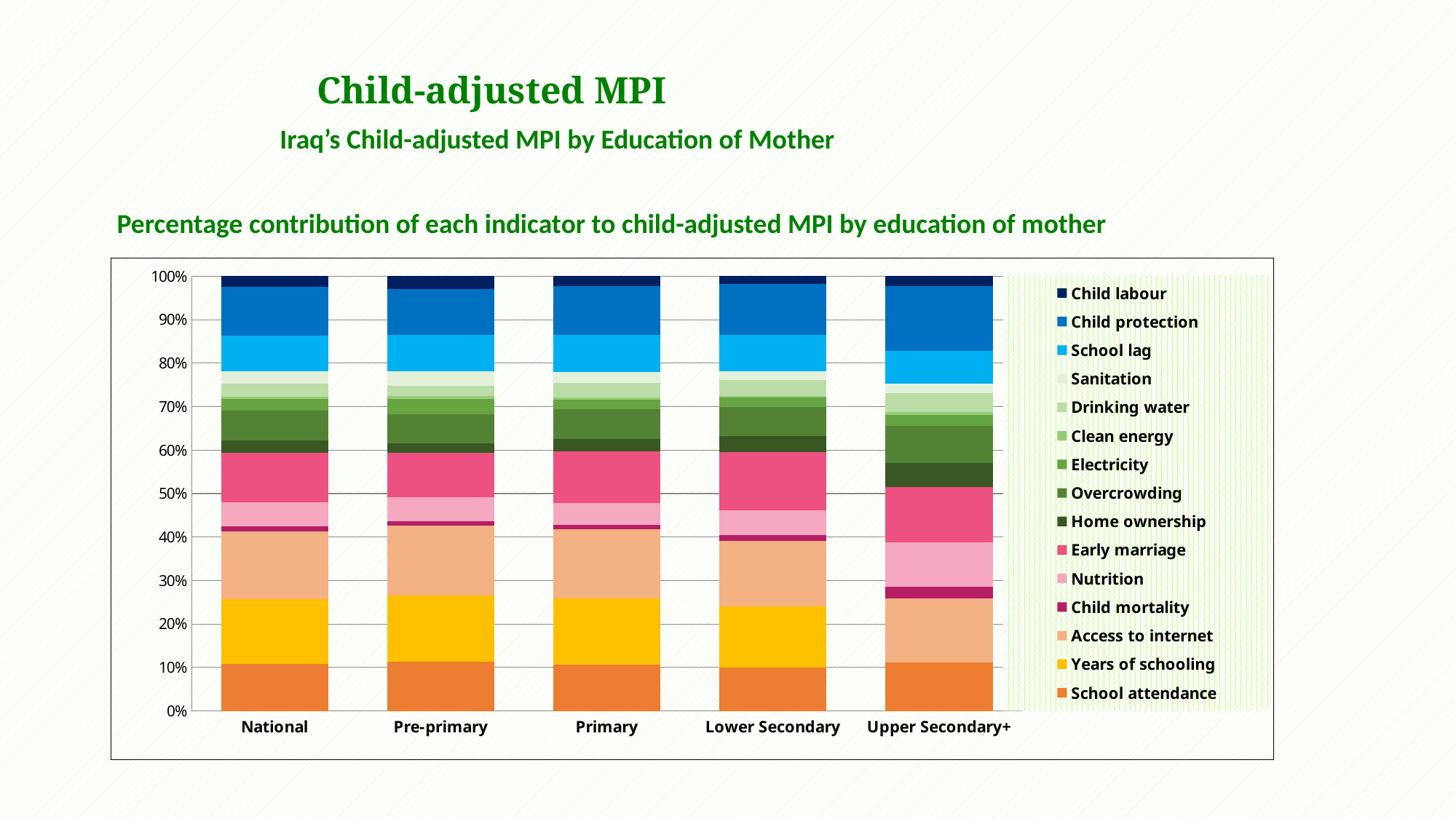
Which category has the largest Overcrowding segment? Upper Secondary+ Is the Child labour segment for National greater or less than 10%? less Which indicator is listed first (at the top) in the legend? Child labour How many indicators does the legend list? 15 Which category has the smallest Years of schooling segment? Upper Secondary+ Is the Years of schooling segment for National greater or less than 10%? greater Which category has the largest Child protection segment? Upper Secondary+ What is the total of the stacked bar for National? 100% How many education-of-mother categories are shown on the x axis? 5 Is the Child protection segment larger for Upper Secondary+ or for National? Upper Secondary+ Which category has the largest Nutrition segment? Upper Secondary+ What kind of chart is shown on the slide? stacked bar chart